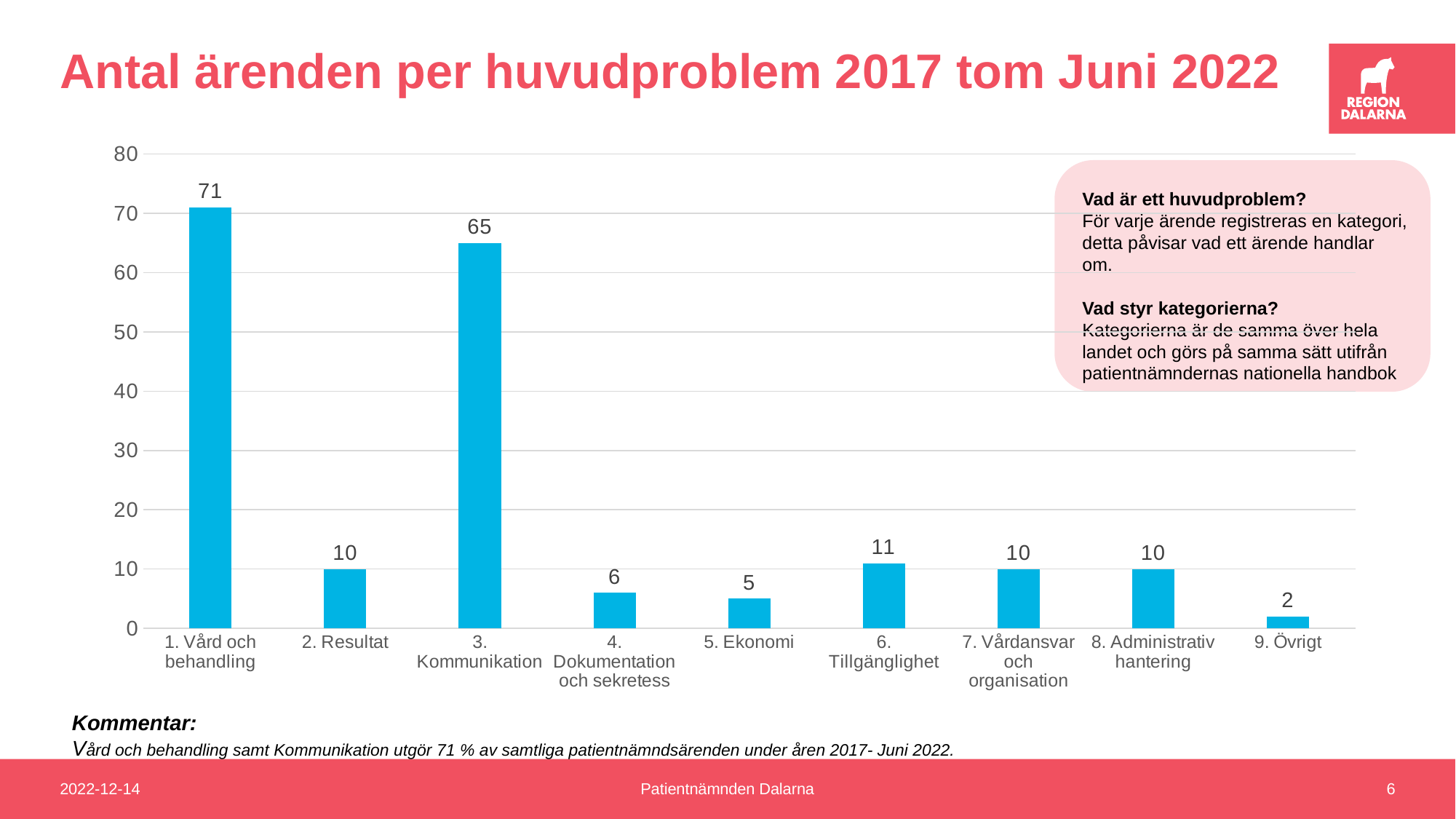
What is the value for '1. Vård och behandling'? 71 How many categories are shown on the x axis? 9 Which is larger, the value for '6. Tillgänglighet' or the value for '4. Dokumentation och sekretess'? 6. Tillgänglighet Is the value for '3. Kommunikation' greater or less than 60? greater Which category has the highest value? 1. Vård och behandling What kind of chart is shown on the slide? bar chart What is the value for '5. Ekonomi'? 5 What is the value for '3. Kommunikation'? 65 What is the value for '9. Övrigt'? 2 Which category has the lowest value? 9. Övrigt What is the difference between the values for '1. Vård och behandling' and '3. Kommunikation'? 6 What is the title of the slide's chart? Antal ärenden per huvudproblem 2017 tom Juni 2022